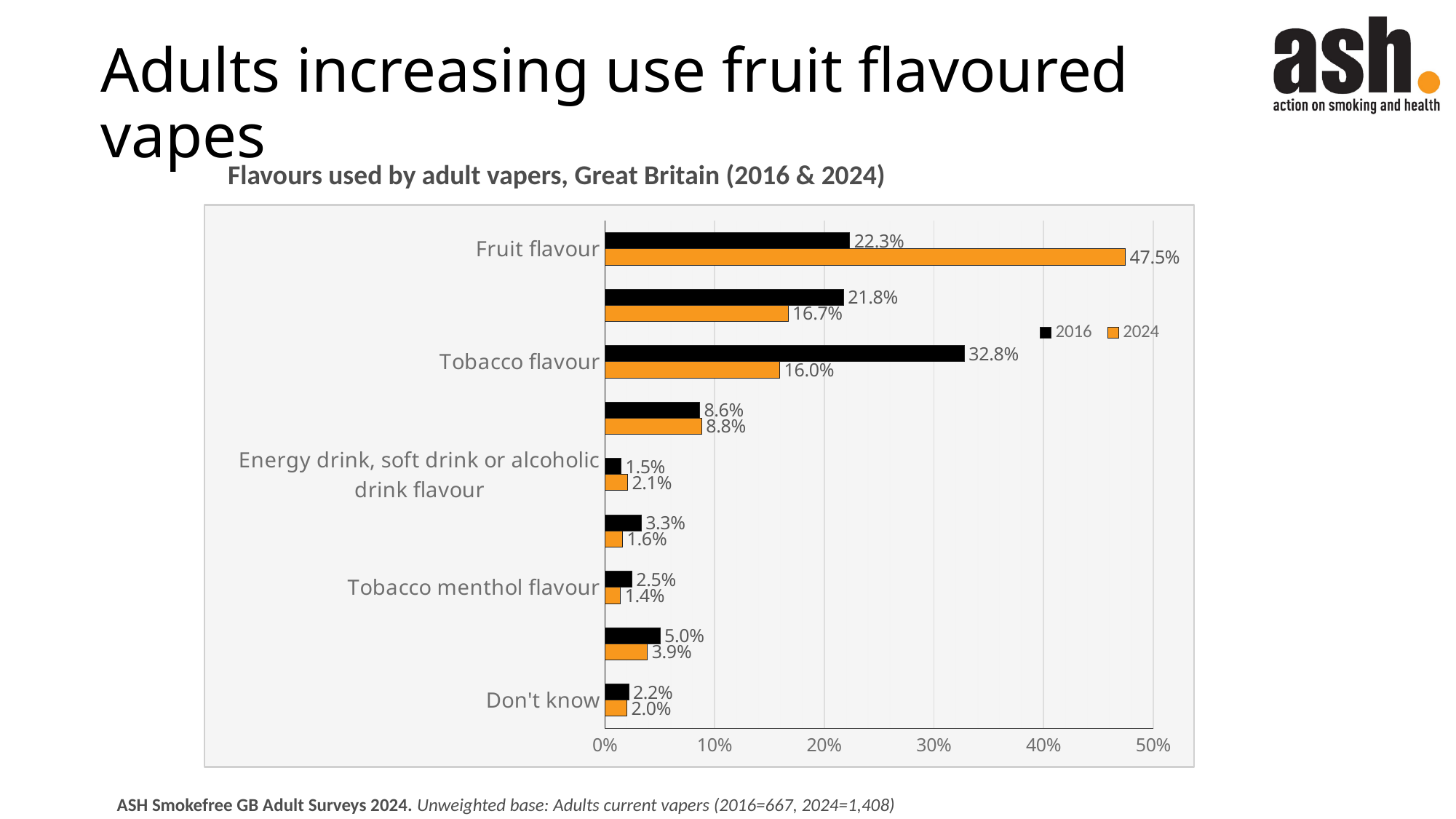
What was the 2016 value for tobacco menthol flavour? 2.5% Which is larger for tobacco flavour: the 2016 value or the 2024 value? 2016 What was the value for tobacco flavour in 2016? 32.8% What percentage of adult vapers used fruit flavour in 2024? 47.5% What was the value for tobacco flavour in 2024? 16.0% Which flavour has the highest 2016 value? Tobacco flavour What percentage of adult vapers used fruit flavour in 2016? 22.3% By how many percentage points did fruit flavour use increase from 2016 to 2024? 25.2 percentage points What was the 2024 value for energy drink, soft drink or alcoholic drink flavour? 2.1% Which flavour has the highest 2024 value? Fruit flavour How many series does the legend list? 2 What type of chart is shown on the slide? Bar chart